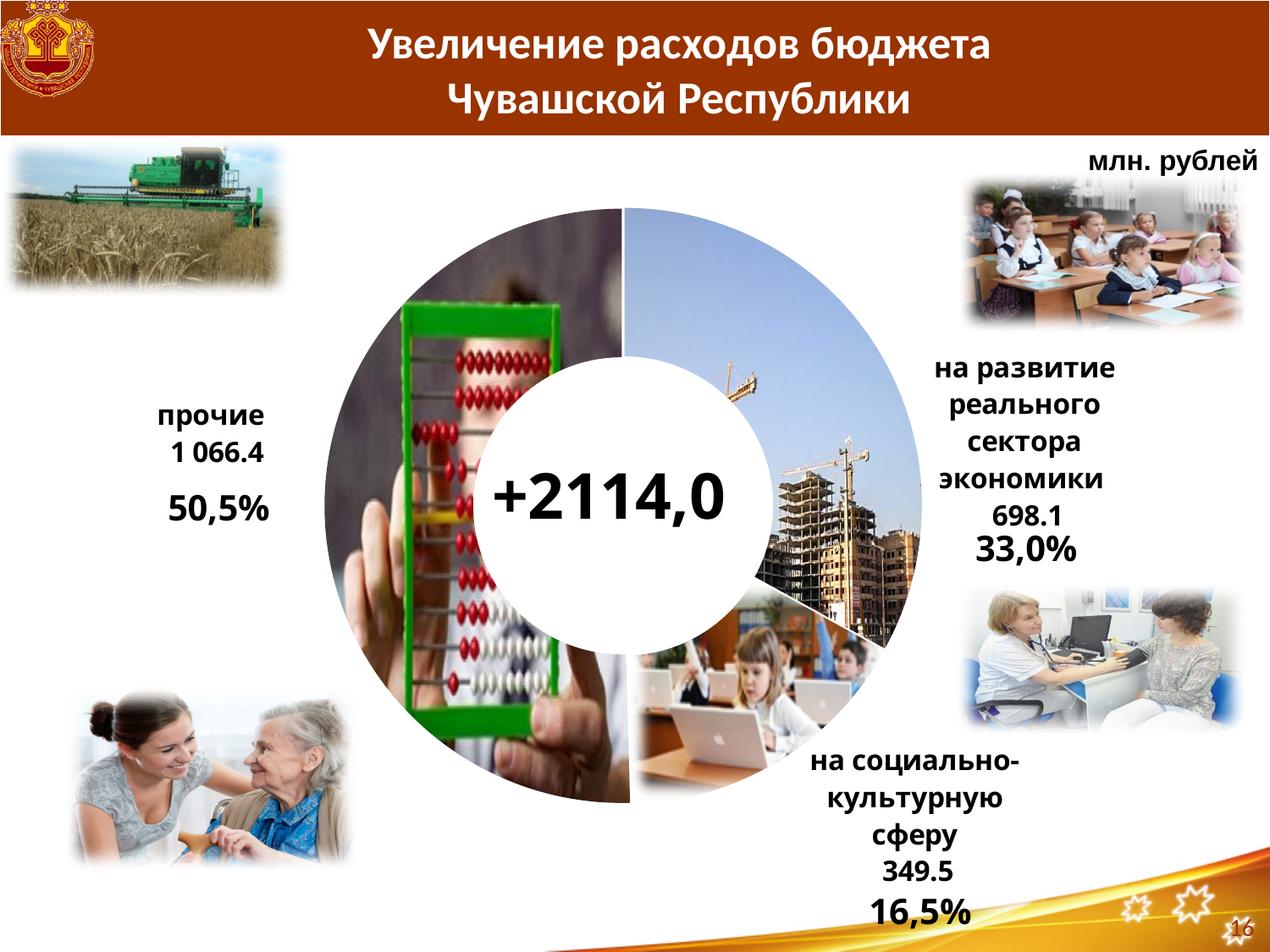
Which segment is the smallest? на социально-культурную сферу What share of the chart does "на социально-культурную сферу" represent? 16,5% What is the value for "на социально-культурную сферу"? 349.5 What is the value for "на развитие реального сектора экономики"? 698.1 What total value is shown in the centre of the chart? +2114,0 Which segment is the largest? прочие In what units are the chart values given? млн. рублей What kind of chart is shown on the slide? doughnut (pie) chart How many segments does the chart have? 3 What share of the chart does "прочие" represent? 50,5% What is the value for "прочие"? 1 066.4 Which is larger: "на развитие реального сектора экономики" or "на социально-культурную сферу"? на развитие реального сектора экономики